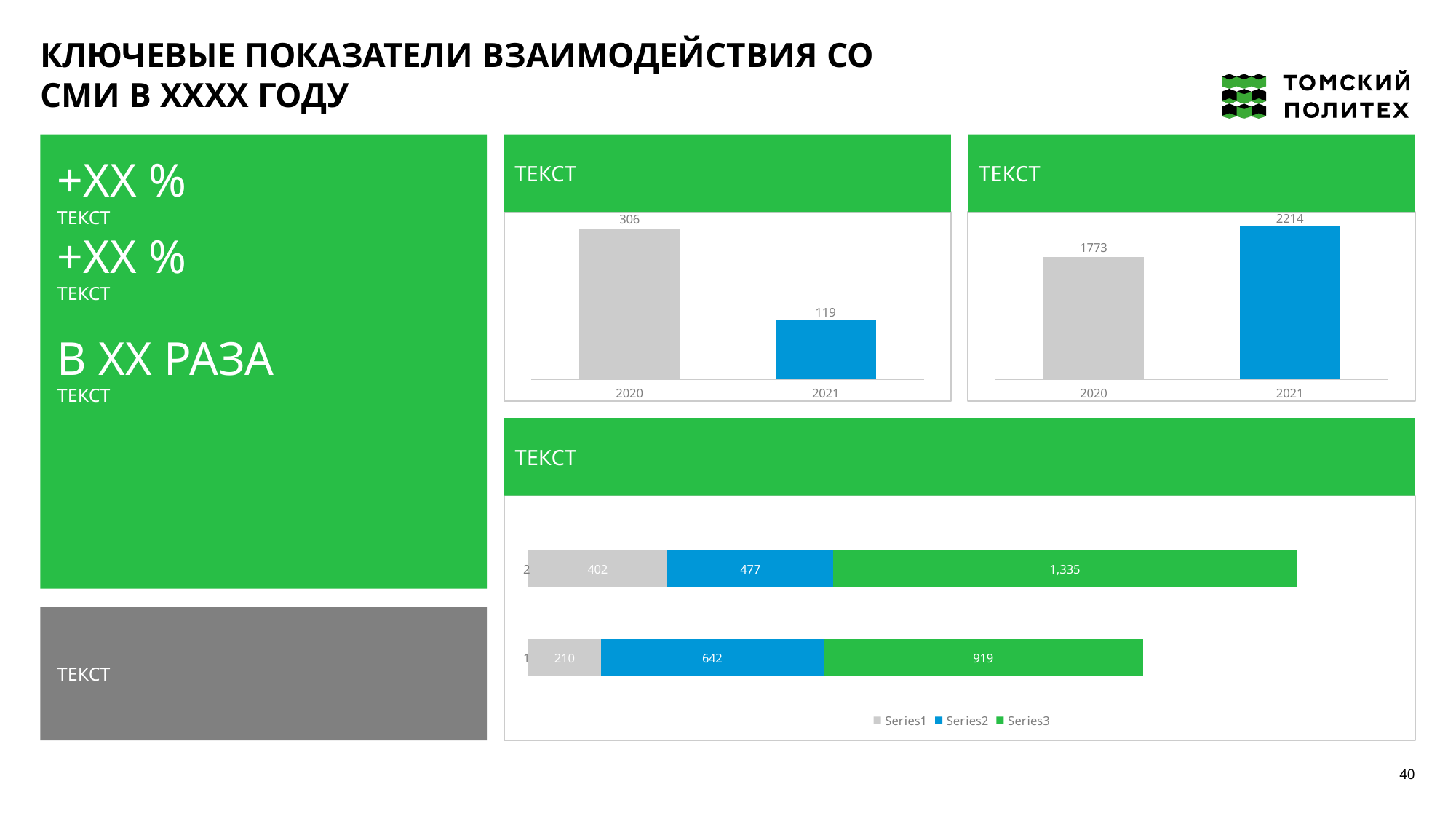
In the top-right chart, which year has the higher value? 2021 In the top-middle chart, what is the value for 2020? 306 In the top-middle chart, do the values rise or fall from 2020 to 2021? fall How many series does the legend of the bottom stacked bar chart list? 3 In the top-right chart, what is the value for 2020? 1773 In the top-right chart, what is the value for 2021? 2214 In the top-middle chart, what is the difference between the 2020 and 2021 values? 187 In the bottom stacked bar chart, what is the total of the bottom bar? 1771 In the bottom stacked bar chart, what is the Series3 value in the top bar? 1,335 In the top-middle chart, what is the value for 2021? 119 What kind of chart is the bottom chart on the slide? stacked bar chart In the top-right chart, what is the difference between the 2021 and 2020 values? 441